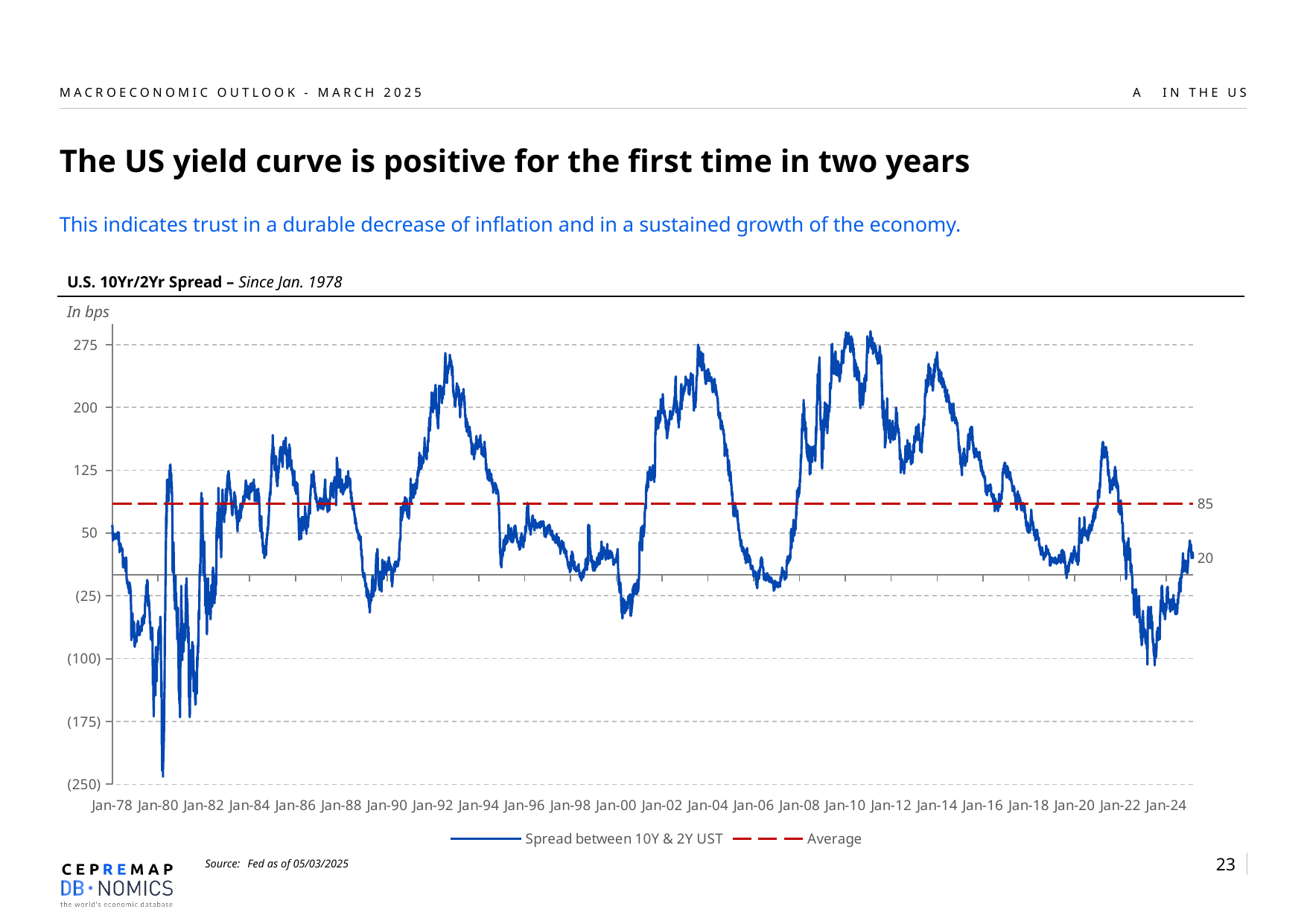
Which is larger: the Average line value or the latest labelled spread value? Average What is the difference between the Average (85) and the latest labelled spread value (20)? 65 What is the latest labelled value of the spread between 10Y & 2Y UST at the right end of the chart? 20 Is the peak value of the spread around Jan-10 greater or less than 200? greater Is the lowest value of the spread around Jan-80 greater or less than (175)? less Between Jan-10 and Jan-18, does the spread generally rise or fall? fall Is the peak value of the spread around Jan-92 greater or less than 200? greater What is the value of the Average line for the U.S. 10Yr/2Yr spread? 85 In what unit are the values on the chart expressed? bps What kind of chart is shown on the slide? line chart What does the dashed red line on the chart represent? Average How many series does the legend list? 2